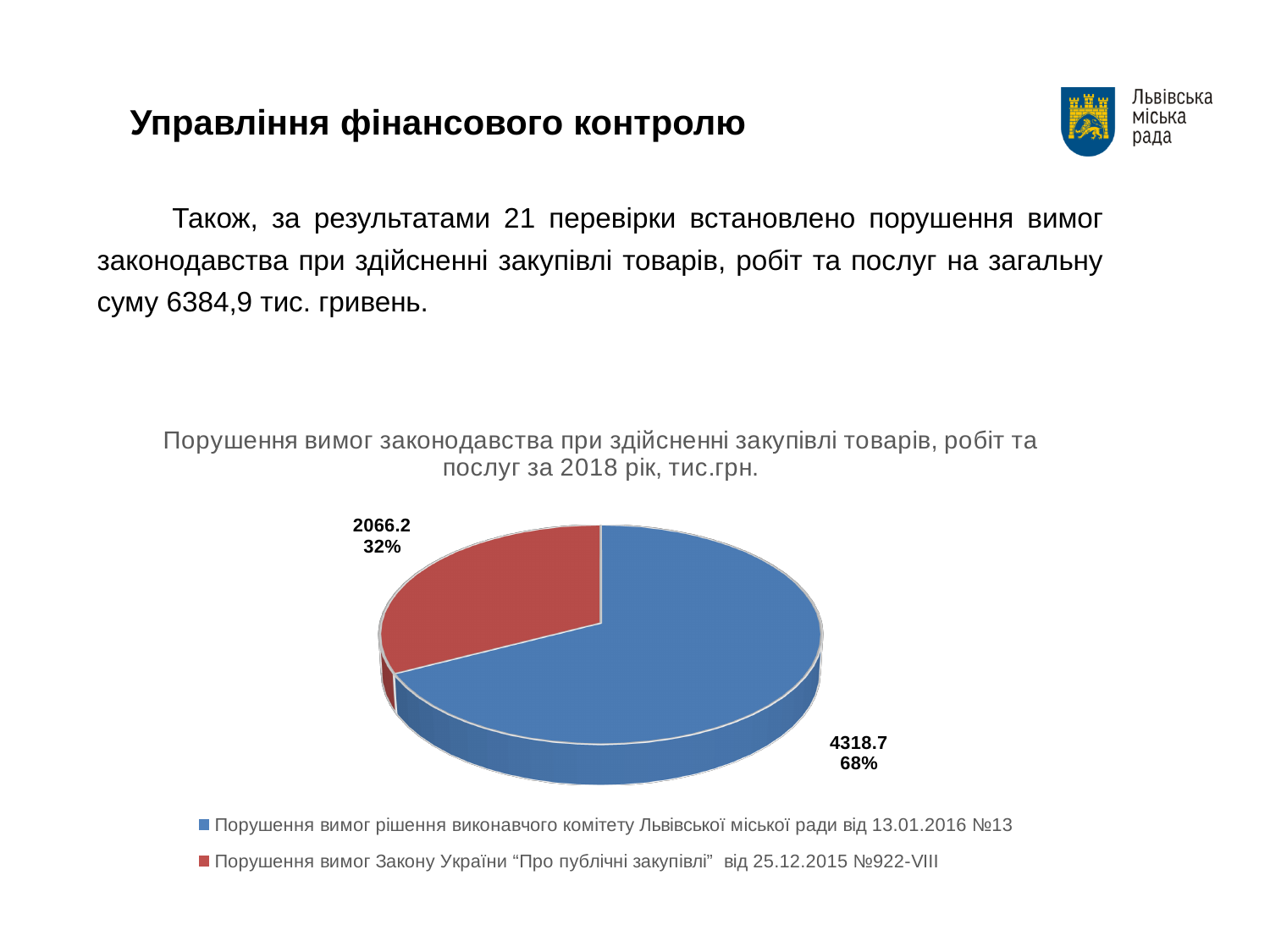
What colour is the slice for "Порушення вимог Закону України “Про публічні закупівлі” від 25.12.2015 №922-VIII"? Red Which category has the largest slice of the pie? Порушення вимог рішення виконавчого комітету Львівської міської ради від 13.01.2016 №13 What type of chart is shown on the slide? Pie chart What is the value for "Порушення вимог рішення виконавчого комітету Львівської міської ради від 13.01.2016 №13"? 4318.7 How many slices does the pie chart have? 2 What is the total of the two slice values shown on the pie chart? 6384.9 What share of the pie does "Порушення вимог Закону України “Про публічні закупівлі” від 25.12.2015 №922-VIII" represent? 32% How many entries does the legend list? 2 What share of the pie does "Порушення вимог рішення виконавчого комітету Львівської міської ради від 13.01.2016 №13" represent? 68% Which category has the smallest slice of the pie? Порушення вимог Закону України “Про публічні закупівлі” від 25.12.2015 №922-VIII What is the value for "Порушення вимог Закону України “Про публічні закупівлі” від 25.12.2015 №922-VIII"? 2066.2 What is the difference between the two slice values (4318.7 and 2066.2)? 2252.5